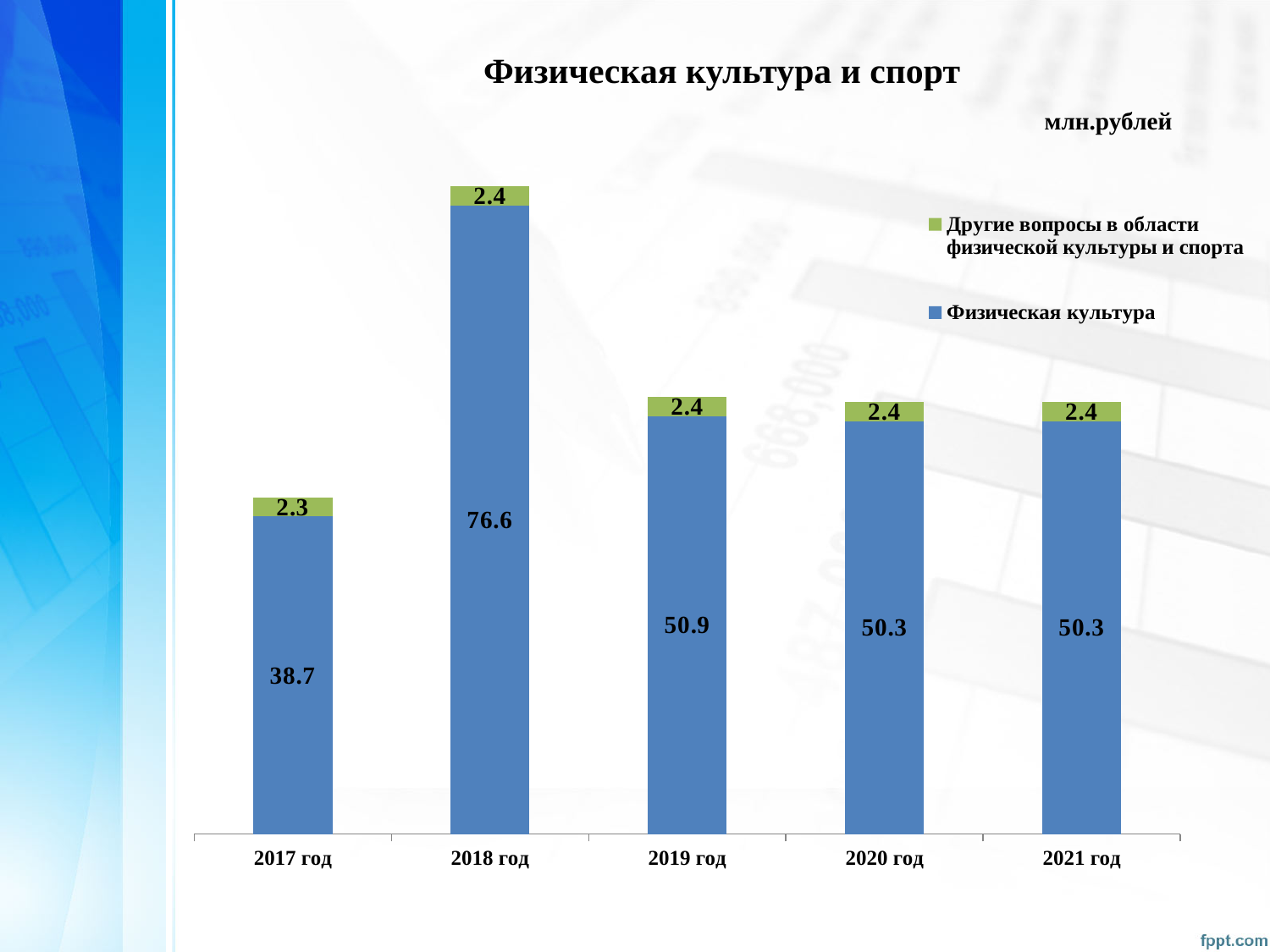
Which year has the lowest value for Физическая культура? 2017 год What type of chart is shown on the slide? Stacked bar chart How many series does the legend list? 2 Which year has the highest value for Физическая культура? 2018 год What is the total of the stacked bar for 2018 год? 79.0 What is the difference between the Физическая культура values for 2018 год and 2019 год? 25.7 What is the value of the Физическая культура series for 2021 год? 50.3 What is the value of the Физическая культура series for 2018 год? 76.6 How many years are shown on the x axis? 5 What is the total of the stacked bar for 2017 год? 41.0 What is the value of the Другие вопросы в области физической культуры и спорта series for 2017 год? 2.3 Which is larger, the Физическая культура value for 2019 год or for 2020 год? 2019 год